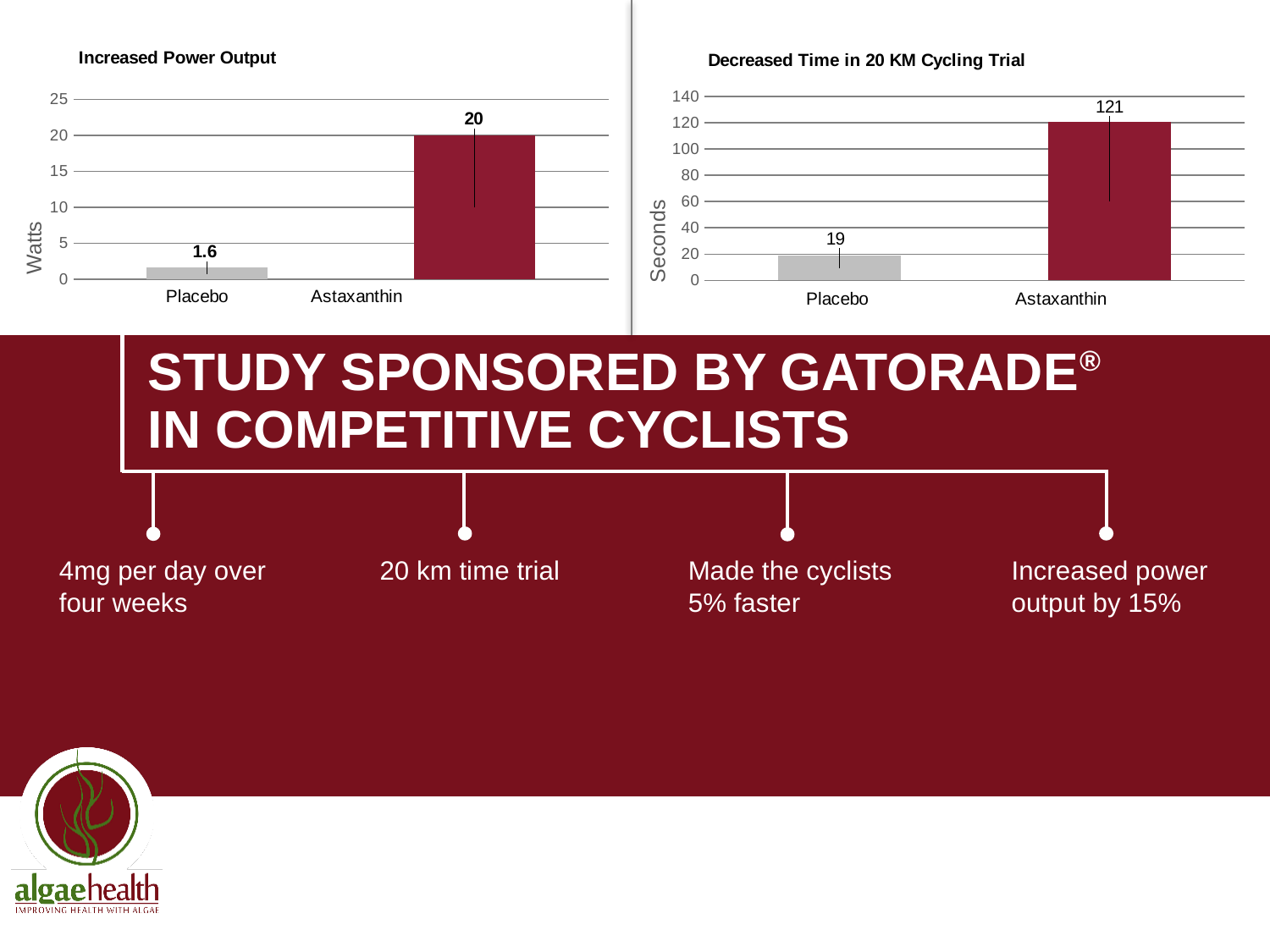
In the 'Increased Power Output' chart, what is the value for Astaxanthin? 20 What is the y-axis label of the 'Increased Power Output' chart? Watts In the 'Decreased Time in 20 KM Cycling Trial' chart, what is the value for Placebo? 19 In the 'Increased Power Output' chart, what is the value for Placebo? 1.6 In the 'Decreased Time in 20 KM Cycling Trial' chart, is the value for Astaxanthin greater or less than 100? greater What kind of chart is the 'Decreased Time in 20 KM Cycling Trial' chart? Bar chart In the 'Decreased Time in 20 KM Cycling Trial' chart, what is the value for Astaxanthin? 121 In the 'Increased Power Output' chart, what is the difference between the Astaxanthin and Placebo values? 18.4 How many categories are shown in the 'Increased Power Output' chart? 2 In the 'Increased Power Output' chart, which category has the highest value? Astaxanthin In the 'Decreased Time in 20 KM Cycling Trial' chart, which category has the lowest value? Placebo In the 'Decreased Time in 20 KM Cycling Trial' chart, what is the difference between the Astaxanthin and Placebo values? 102